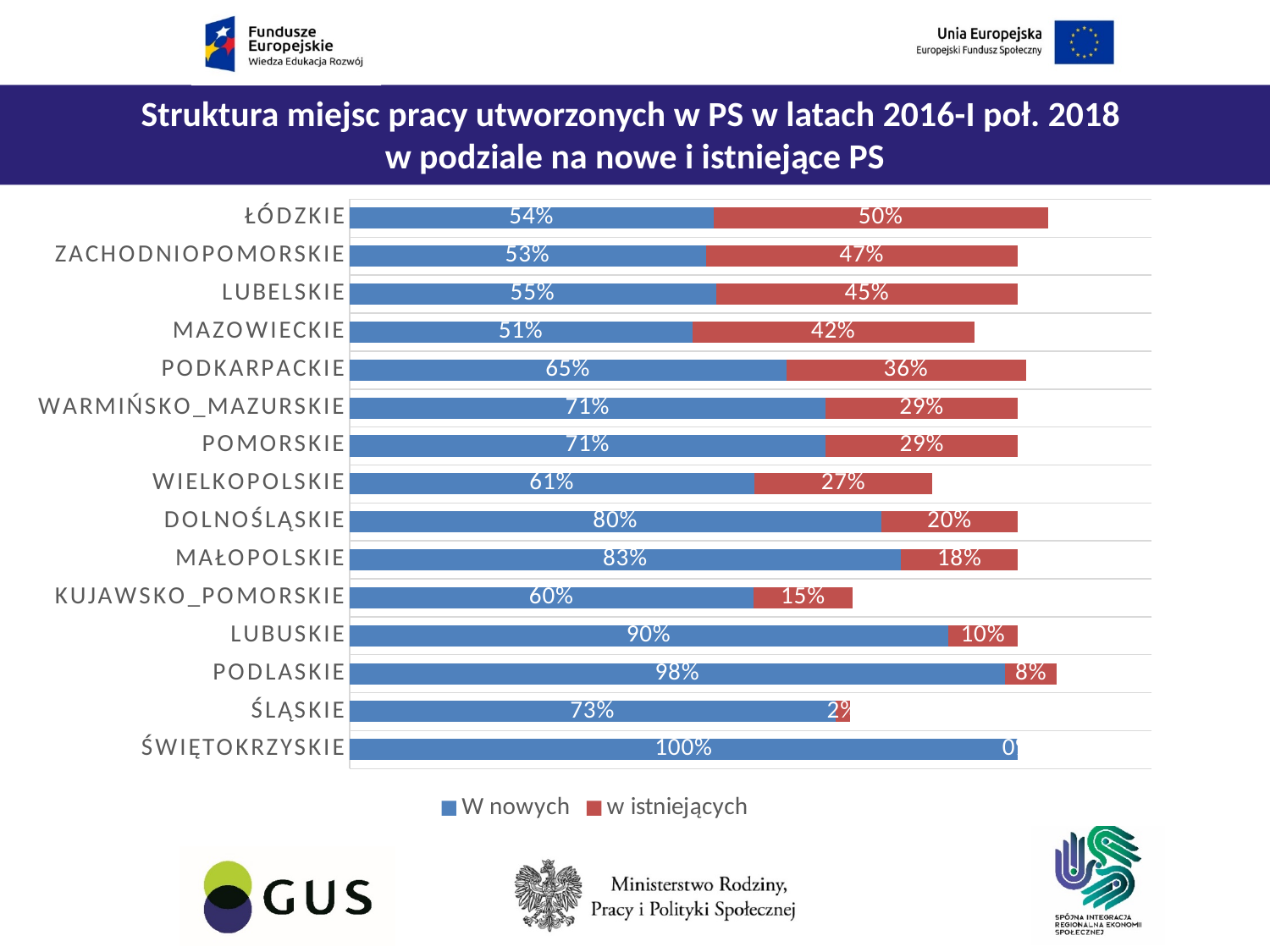
What are the two series named in the legend? W nowych and w istniejących What is the difference between the 'W nowych' and 'w istniejących' values for LUBUSKIE? 80 percentage points How many series does the legend list? 2 How many regions are shown on the chart? 15 What is the value for ŁÓDZKIE in the 'W nowych' series? 54% Which region has the highest value in the 'W nowych' series? ŚWIĘTOKRZYSKIE What is the value for PODLASKIE in the 'w istniejących' series? 8% Which region has the highest value in the 'w istniejących' series? ŁÓDZKIE What kind of chart is shown on the slide? Stacked bar chart Which has a larger 'W nowych' value, PODKARPACKIE or WIELKOPOLSKIE? PODKARPACKIE Which region has the lowest value in the 'W nowych' series? MAZOWIECKIE What is the value for MAŁOPOLSKIE in the 'w istniejących' series? 18%